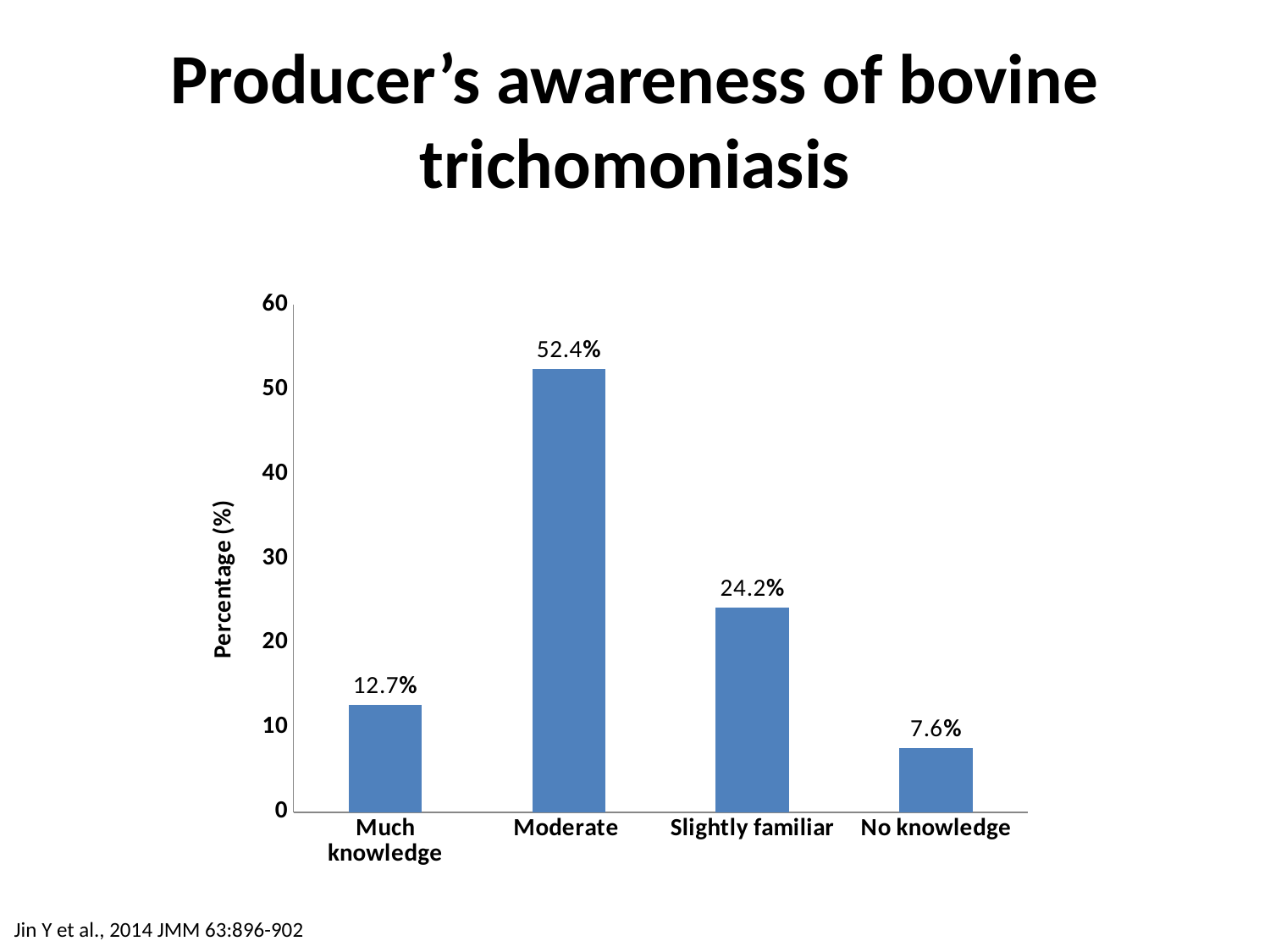
What is the title of the chart on the slide? Producer's awareness of bovine trichomoniasis What is the label of the y axis? Percentage (%) What is the value shown for the 'No knowledge' category? 7.6% Which category has the lowest percentage? No knowledge Which category has the highest percentage? Moderate How many categories are shown on the x axis? 4 What kind of chart is shown on the slide? Bar chart What percentage of producers reported moderate awareness of bovine trichomoniasis? 52.4% Is the value for 'Slightly familiar' greater or less than 20? greater Which is larger, the value for 'Much knowledge' or the value for 'No knowledge'? Much knowledge What percentage of producers were 'Slightly familiar' with bovine trichomoniasis? 24.2% What is the difference between the 'Moderate' and 'Slightly familiar' percentages? 28.2%